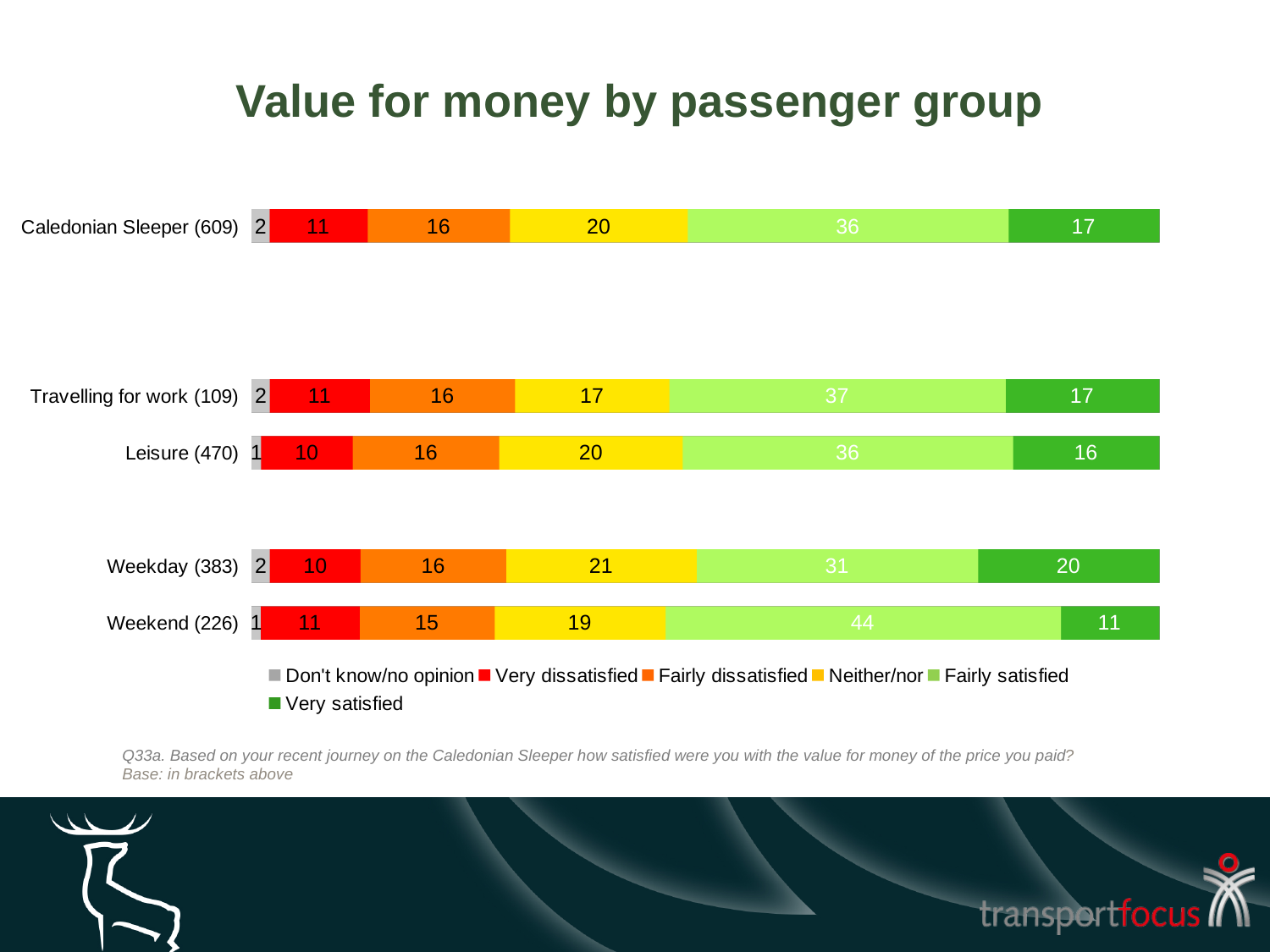
What is the difference between the Fairly satisfied values for Weekend (226) and Weekday (383)? 13 What is the Very dissatisfied value for Caledonian Sleeper (609)? 11 How many series does the legend list? 6 What is the Very satisfied value for Weekday (383)? 20 Which is larger, the Very satisfied value for Weekday (383) or for Leisure (470)? Weekday (383) Which passenger group has the highest Fairly satisfied value? Weekend (226) What is the Fairly satisfied value for Weekend (226)? 44 What is the Neither/nor value for Travelling for work (109)? 17 How many passenger groups are plotted in the chart? 5 What is the title of the chart? Value for money by passenger group Which passenger group has the lowest Very satisfied value? Weekend (226) What kind of chart is shown on the slide? Stacked bar chart